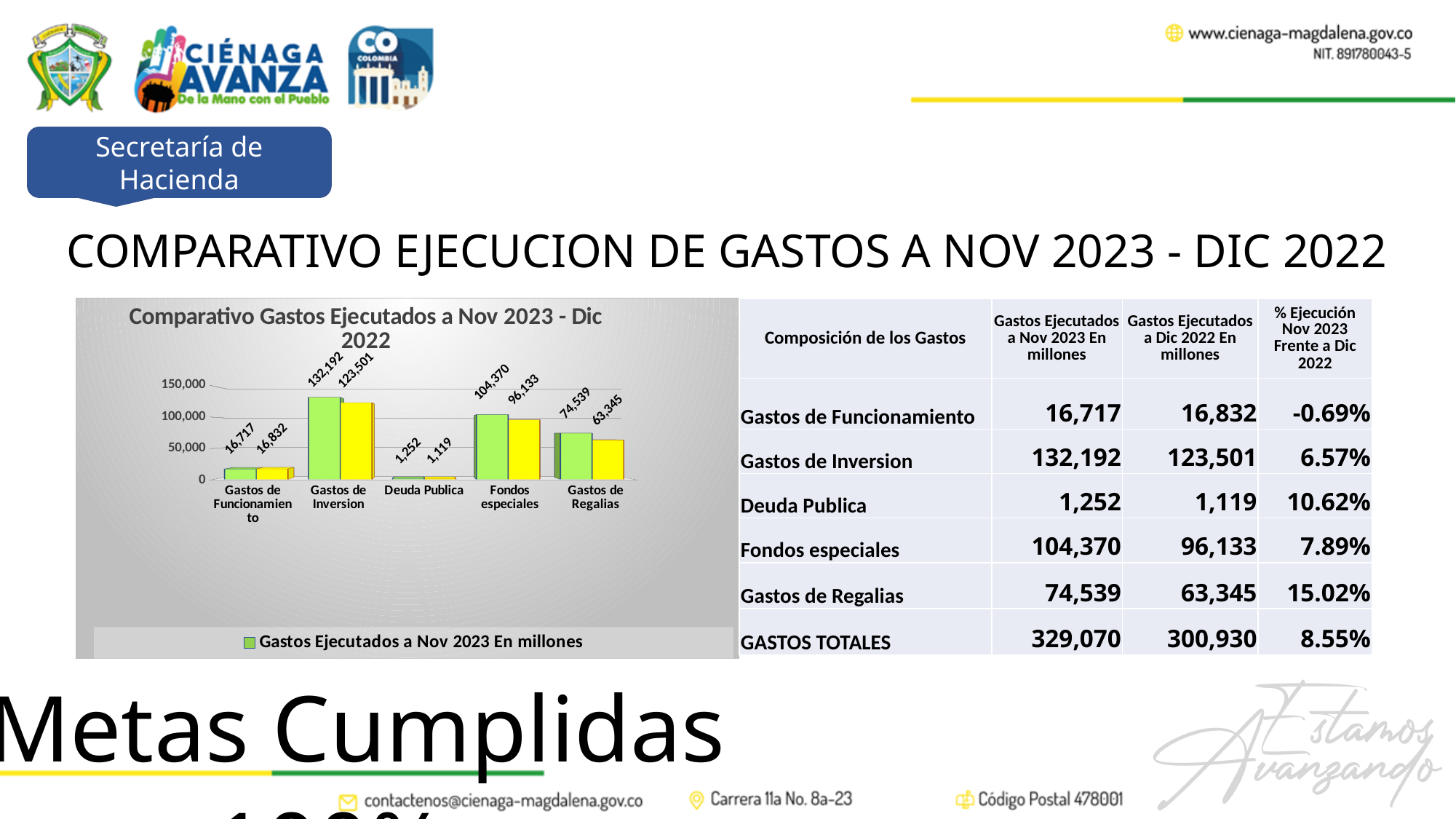
Which category has the lowest value for Gastos Ejecutados a Nov 2023? Deuda Publica What is the value of Gastos Ejecutados a Nov 2023 for Gastos de Inversion? 132,192 What is the title of the chart? Comparativo Gastos Ejecutados a Nov 2023 - Dic 2022 Which category has the highest value for Gastos Ejecutados a Nov 2023? Gastos de Inversion What is the difference between the Nov 2023 and Dic 2022 values for Gastos de Regalias? 11,194 What is the difference between the Nov 2023 and Dic 2022 values for Gastos de Inversion? 8,691 What is the Nov 2023 value for Deuda Publica in the chart? 1,252 What is the Dic 2022 value for Fondos especiales in the chart? 96,133 What kind of chart is shown on the slide? bar chart How many expense categories are shown on the x axis of the chart? 5 Is the Nov 2023 value for Fondos especiales greater or less than 100,000? greater Which is larger for Gastos de Funcionamiento: the Nov 2023 value or the Dic 2022 value? Dic 2022 (16,832)